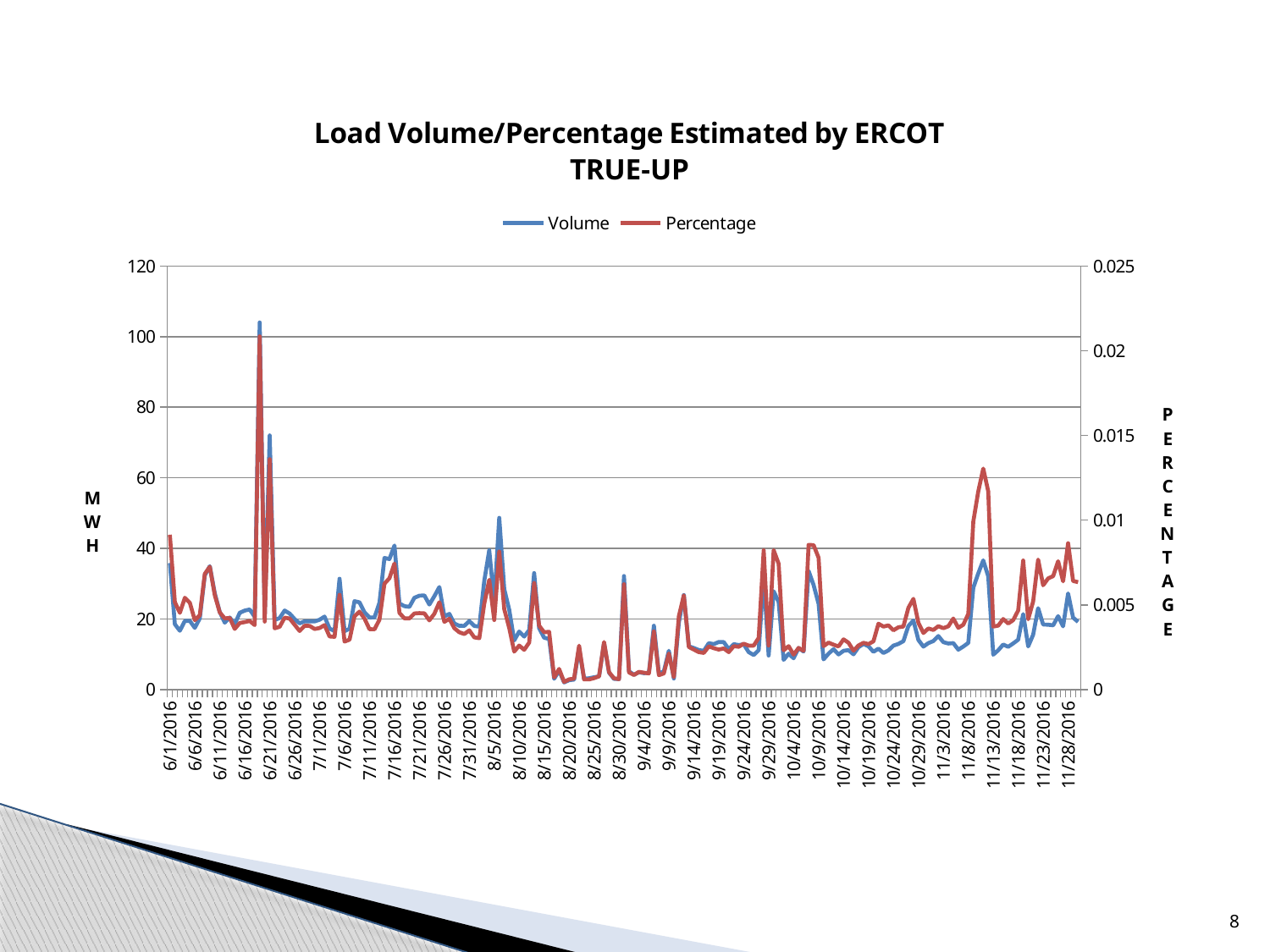
How many series does the legend list? 2 What are the two series named in the legend? Volume and Percentage What is the title of the chart? Load Volume/Percentage Estimated by ERCOT TRUE-UP Which is larger, the Percentage value around 11/10/2016 or the Percentage value around 10/19/2016? 11/10/2016 In which month does the Volume series reach its highest value? June What kind of chart is shown on the slide? line chart Is the highest value of the Volume series greater or less than 80? greater Is the Volume value around 11/13/2016 greater or less than 40? less Is the Volume value around 8/20/2016 greater or less than 20? less